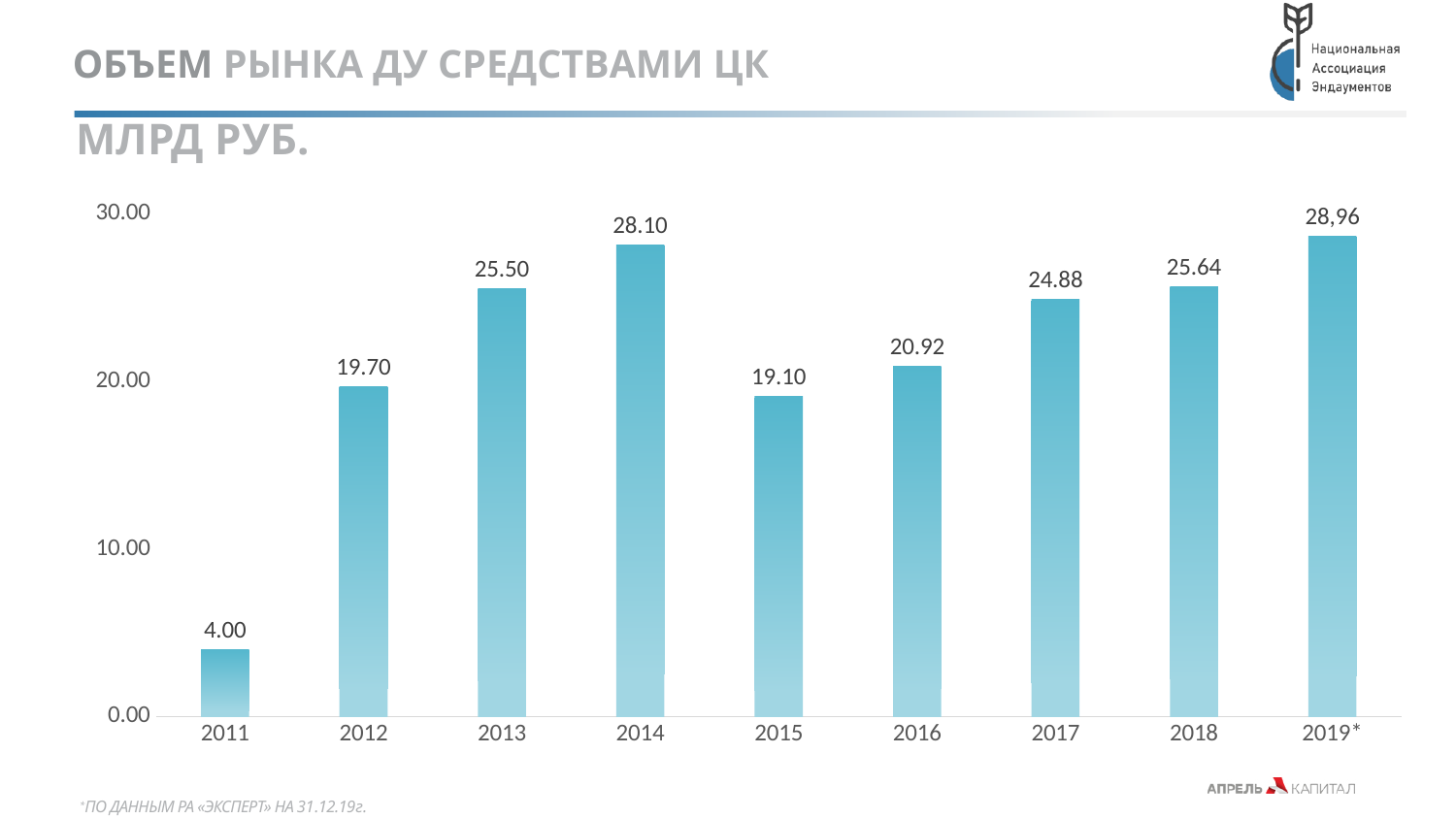
What is the difference between the values for 2014 and 2013? 2.60 What is the difference between the values for 2012 and 2011? 15.70 What kind of chart is shown on the slide? bar chart What is the value for 2011? 4.00 Which is larger, the value for 2015 or the value for 2016? 2016 What is the value for 2019*? 28,96 Which year has the lowest value? 2011 Which year has the highest value? 2019* How many years are shown on the x axis? 9 What is the value for 2014? 28.10 Do the values rise or fall from 2015 to 2019*? rise Is the value for 2017 greater or less than 20.00? greater